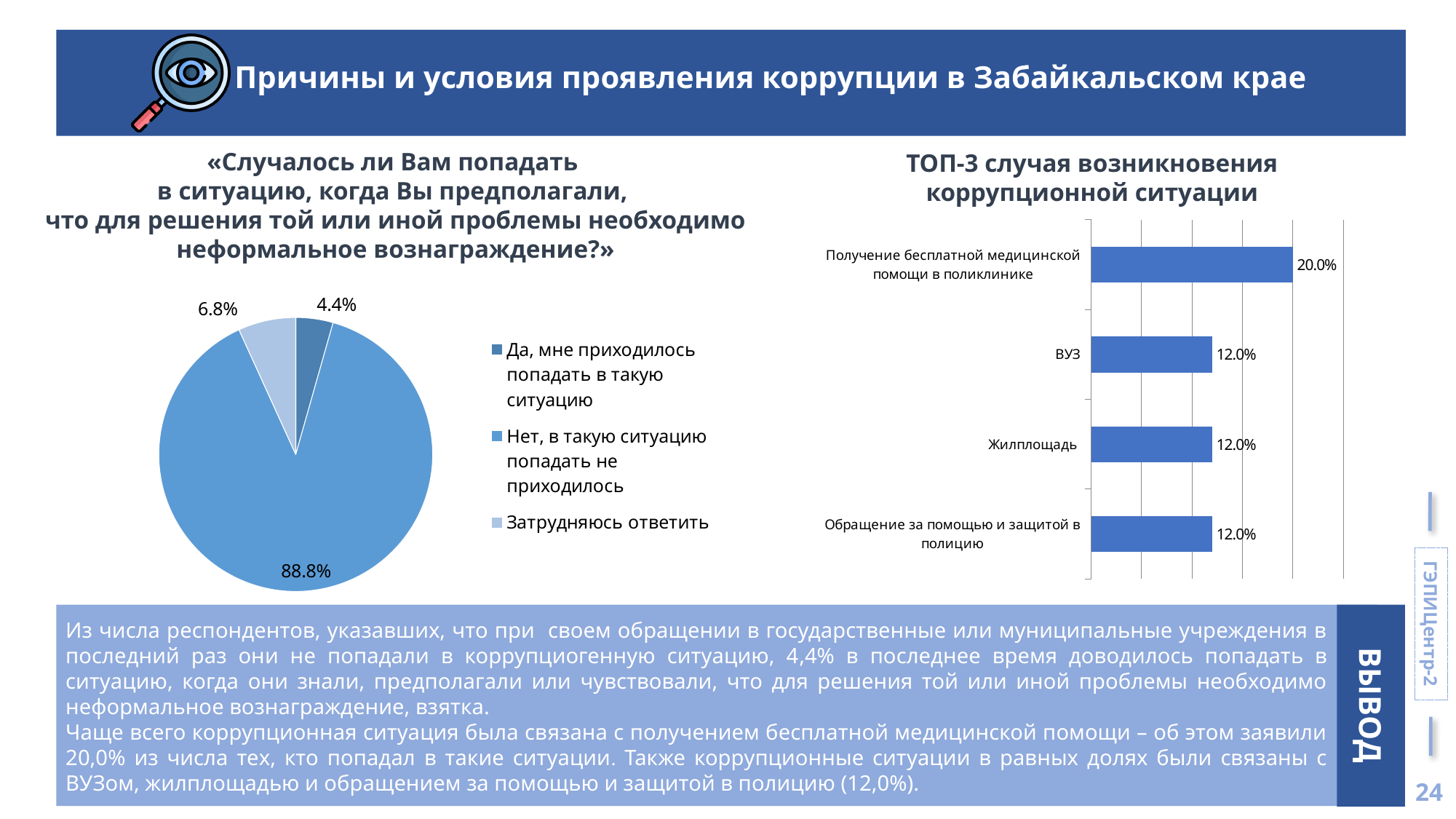
On the pie chart on the left, which answer has the largest share? Нет, в такую ситуацию попадать не приходилось On the chart «ТОП-3 случая возникновения коррупционной ситуации», which category has the highest value? Получение бесплатной медицинской помощи в поликлинике On the pie chart on the left, how many entries does the legend list? 3 On the pie chart on the left, which answer has the smallest share? Да, мне приходилось попадать в такую ситуацию On the pie chart on the left, what share of respondents answered «Да, мне приходилось попадать в такую ситуацию»? 4.4% What type of chart is «ТОП-3 случая возникновения коррупционной ситуации»? Bar chart On the pie chart on the left, what is the difference between the shares for «Затрудняюсь ответить» and «Да, мне приходилось попадать в такую ситуацию»? 2.4% On the pie chart on the left, what share of respondents answered «Затрудняюсь ответить»? 6.8% On the chart «ТОП-3 случая возникновения коррупционной ситуации», what is the value for «Получение бесплатной медицинской помощи в поликлинике»? 20.0% On the pie chart on the left, what share of respondents answered «Нет, в такую ситуацию попадать не приходилось»? 88.8% On the chart «ТОП-3 случая возникновения коррупционной ситуации», what is the value for «ВУЗ»? 12.0% On the chart «ТОП-3 случая возникновения коррупционной ситуации», how many categories are plotted? 4